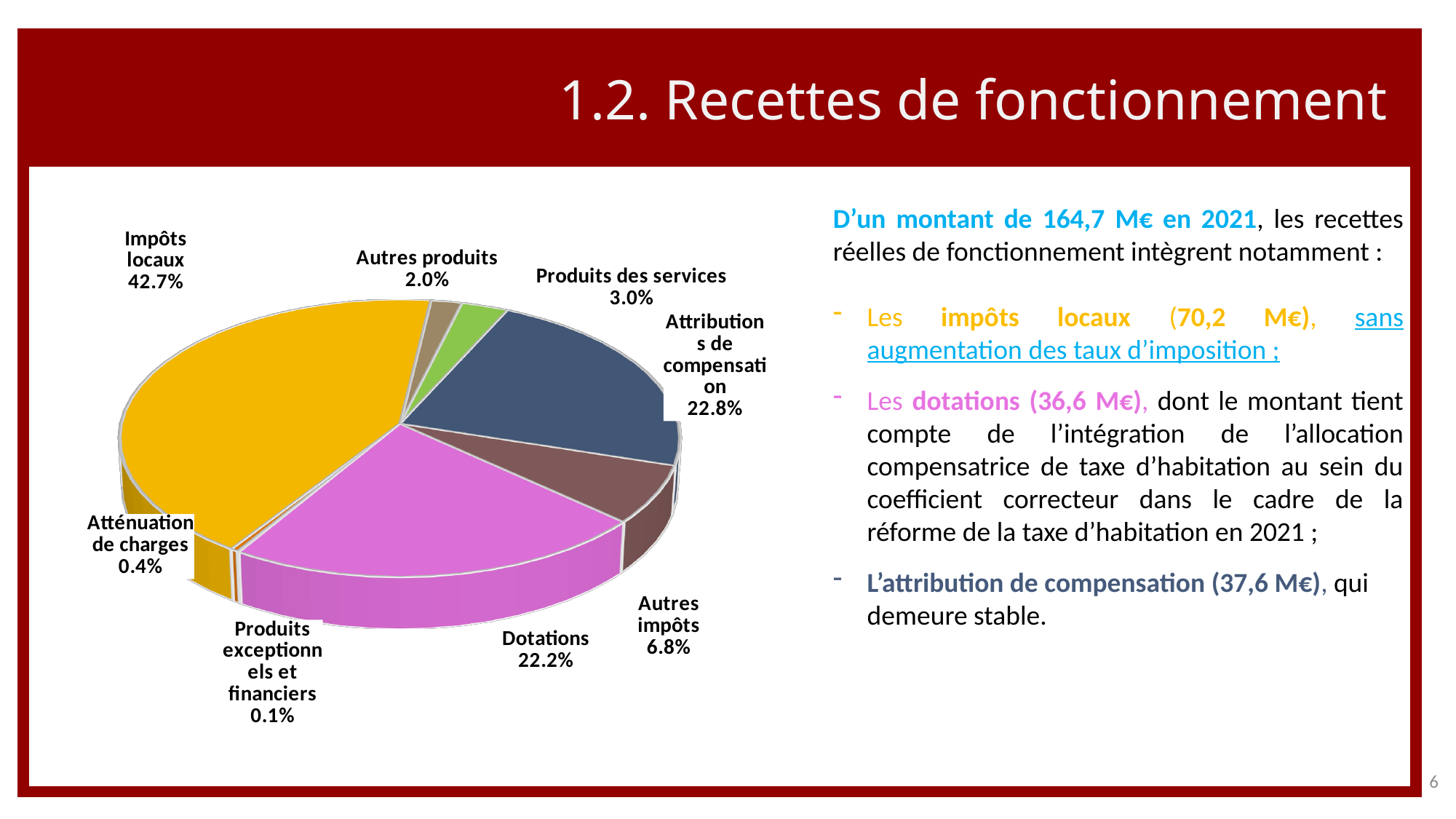
What colour is the Dotations slice? Pink What is the value shown for Produits exceptionnels et financiers? 0.1% What kind of chart is shown on the slide? Pie chart What is the difference in percentage points between Impôts locaux and Dotations? 20.5 What is the value shown for Dotations? 22.2% Which is larger, Produits des services or Autres produits? Produits des services Which category has the largest slice of the pie? Impôts locaux What is the value shown for Autres impôts? 6.8% How many slices does the pie chart have? 8 Which category has the smallest slice of the pie? Produits exceptionnels et financiers What share of the pie does Impôts locaux represent? 42.7% What is the value shown for Attributions de compensation? 22.8%